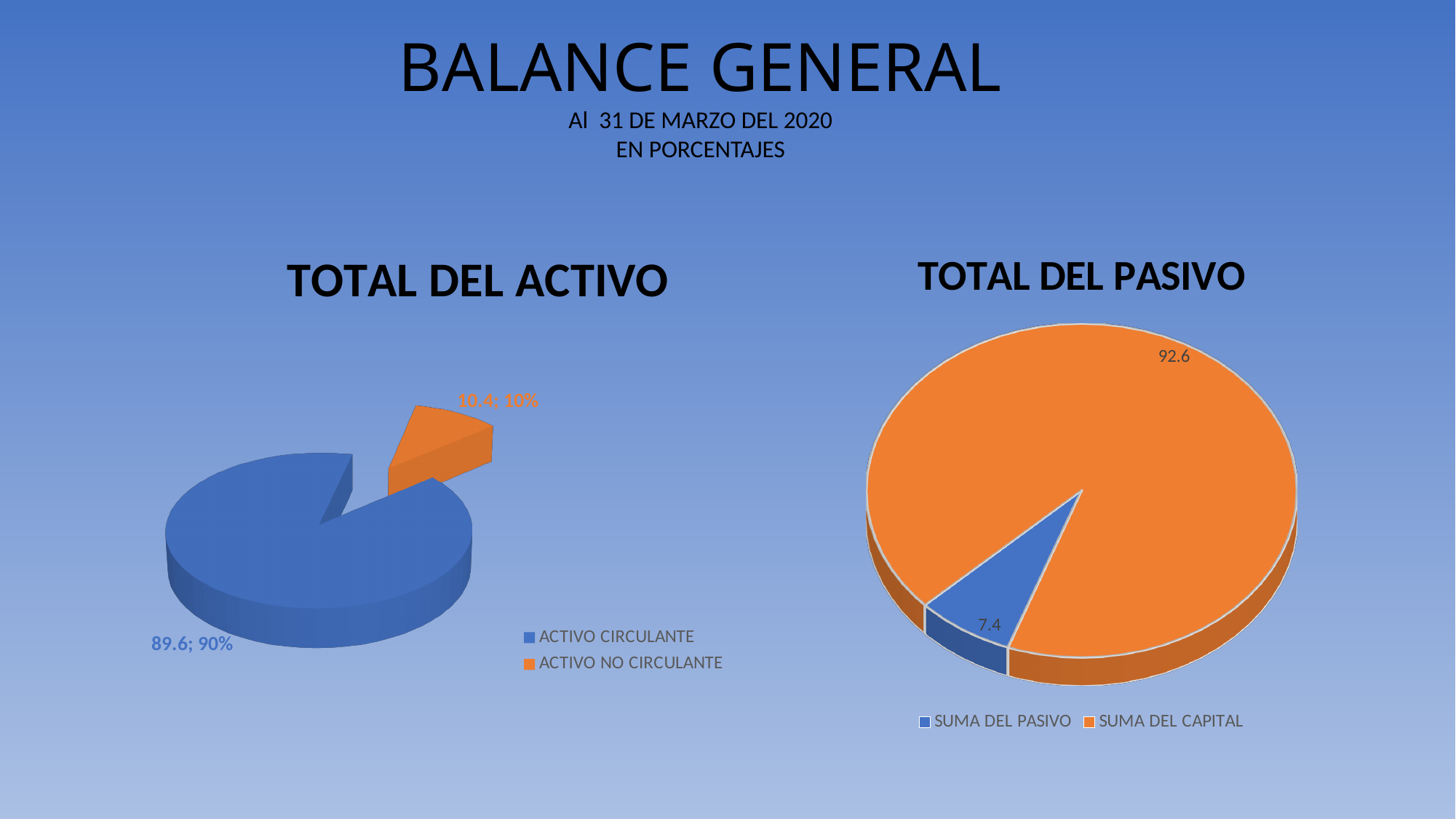
In the "TOTAL DEL PASIVO" chart, what is the value for SUMA DEL CAPITAL? 92.6 In the "TOTAL DEL ACTIVO" chart, what percentage share does ACTIVO NO CIRCULANTE have? 10% In the "TOTAL DEL ACTIVO" chart, which slice is the largest? ACTIVO CIRCULANTE In the "TOTAL DEL PASIVO" chart, which slice is the smallest? SUMA DEL PASIVO In the "TOTAL DEL ACTIVO" chart, what is the data label shown for ACTIVO NO CIRCULANTE? 10.4; 10% In the "TOTAL DEL PASIVO" chart, what is the difference between SUMA DEL CAPITAL and SUMA DEL PASIVO? 85.2 In the "TOTAL DEL ACTIVO" chart, what is the data label shown for ACTIVO CIRCULANTE? 89.6; 90% What kind of chart is the "TOTAL DEL ACTIVO" chart? Pie chart In the "TOTAL DEL PASIVO" chart, how many entries does the legend list? 2 In the "TOTAL DEL ACTIVO" chart, how many slices does the pie have? 2 In the "TOTAL DEL PASIVO" chart, what is the value for SUMA DEL PASIVO? 7.4 In the "TOTAL DEL PASIVO" chart, what colour is the SUMA DEL CAPITAL slice? Orange